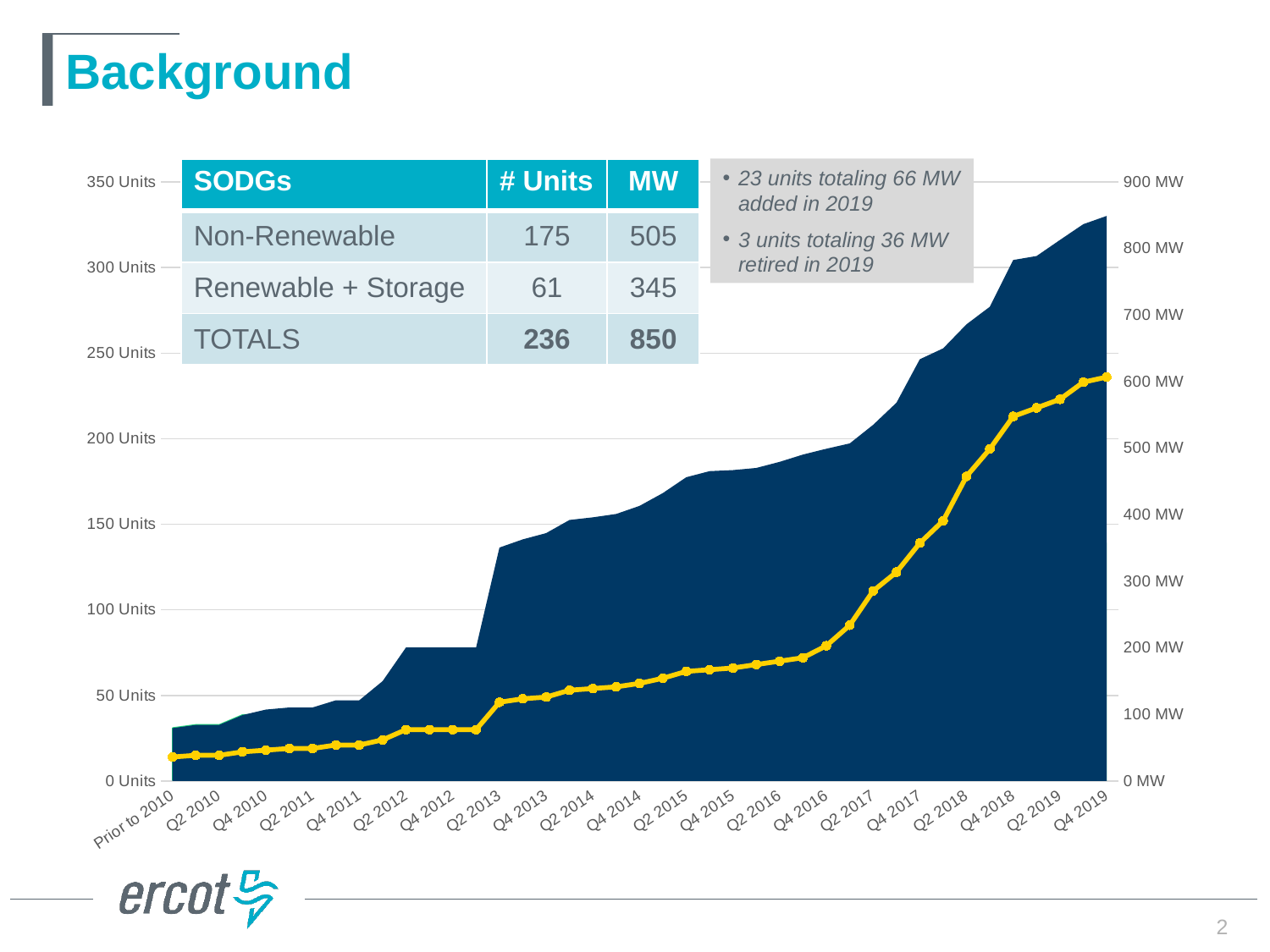
What colour is the line plotted over the shaded area in the chart? Yellow What kind of chart is shown on the slide? Area chart with a line overlaid At which x-axis category is the shaded area at its lowest value? Prior to 2010 At which x-axis category does the shaded area reach its highest value? Q4 2019 Do the values in the chart generally rise or fall from 'Prior to 2010' to 'Q4 2019'? Rise What unit is shown on the right-hand vertical axis of the chart? MW